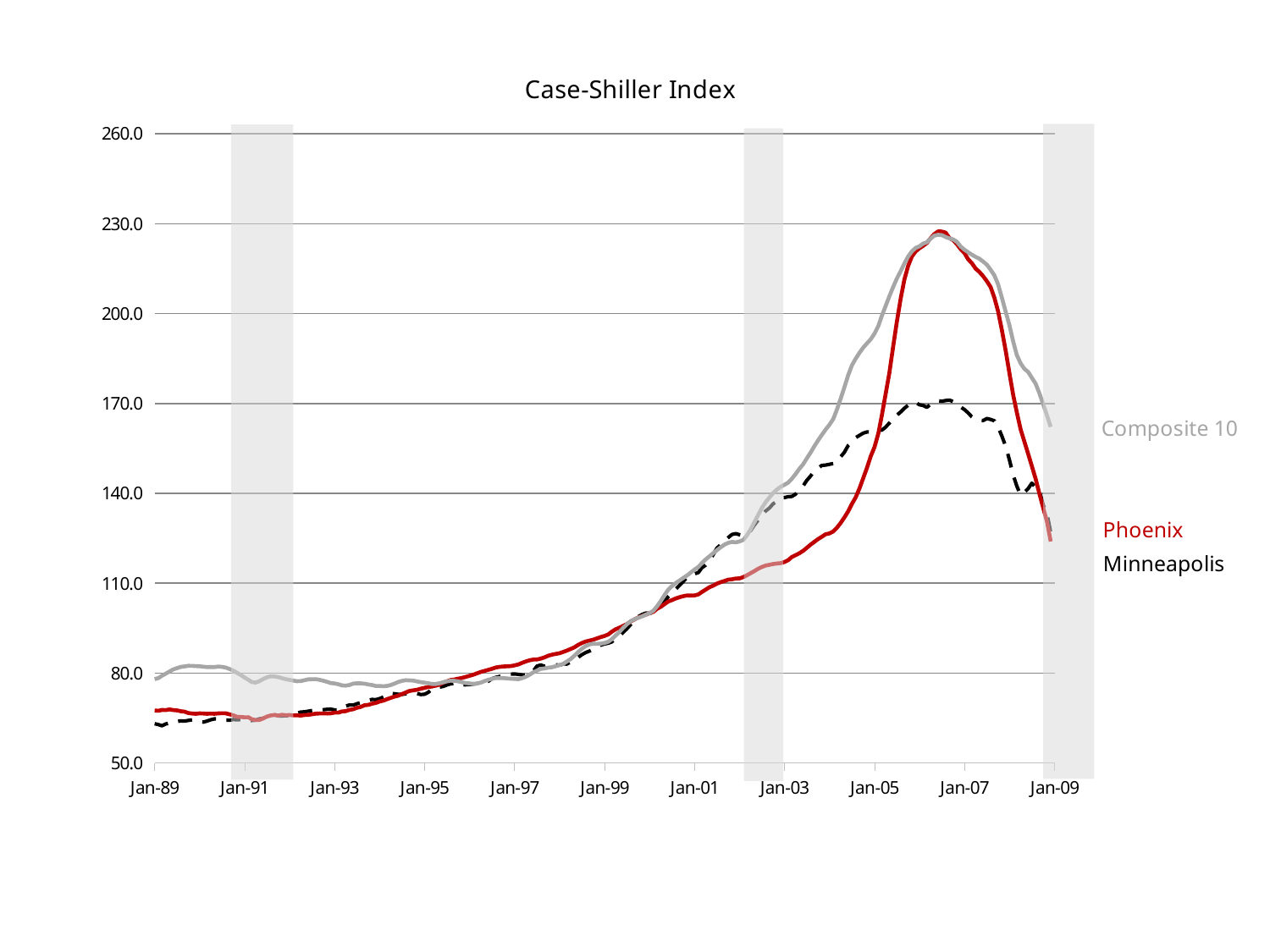
What is the title of the chart? Case-Shiller Index Is the value for Minneapolis at Jan-05 greater or less than 140? greater Which series reaches the lowest peak value over the period shown? Minneapolis At Jan-07, which series has the higher value, Phoenix or Minneapolis? Phoenix At Jan-05, which series has the higher value, Composite 10 or Phoenix? Composite 10 Which series is drawn as a dashed black line? Minneapolis Is the value for Phoenix at Jan-89 greater or less than 80? less Is the value for Composite 10 at Jan-05 greater or less than 170? greater Does the Phoenix series rise or fall between Jan-07 and Jan-09? fall How many series are plotted on the Case-Shiller Index chart? 3 What kind of chart is shown on the slide? line chart